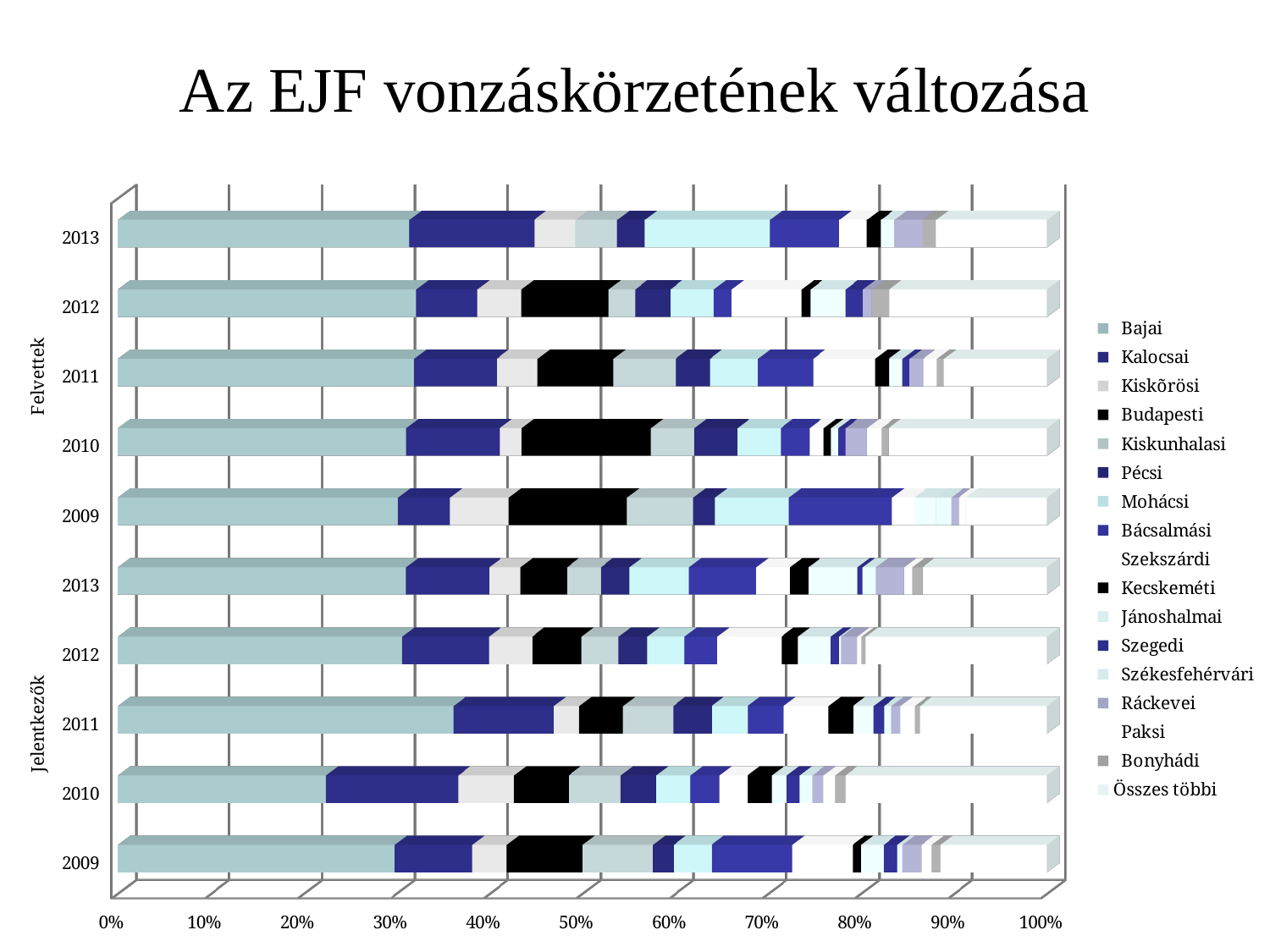
What is the highest value shown on the x axis? 100% Which is larger, the Budapesti share for Felvettek 2010 or for Felvettek 2013? Felvettek 2010 Which is larger, the Bajai share for Jelentkezők 2011 or for Jelentkezők 2010? Jelentkezők 2011 Which legend entry is listed first? Bajai What is the title of the chart? Az EJF vonzáskörzetének változása Is the Bajai share for Felvettek 2013 greater or less than 30%? greater How many series does the legend list? 17 Is the Bajai share for Jelentkezők 2011 greater or less than 30%? greater Which bar has the smallest Bajai share? Jelentkezők 2010 What kind of chart is shown on the slide? Stacked bar chart How many bars are plotted in the chart? 10 Is the Bajai share for Jelentkezők 2010 greater or less than 30%? less